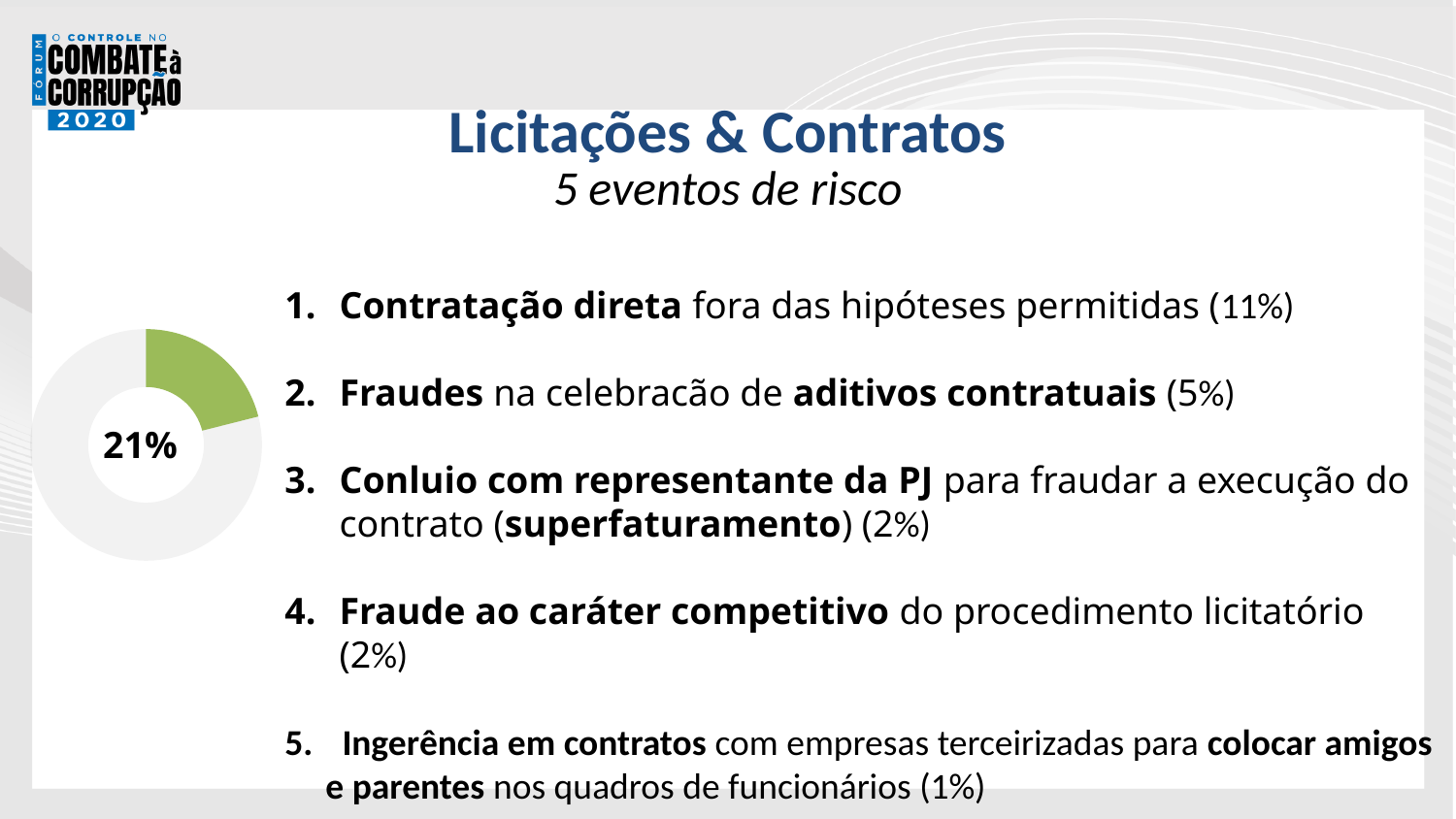
Does the donut chart include a legend? No What share of the donut chart does the green slice represent? 21% What kind of chart is shown on the left of the slide? Pie chart (donut) What colour is the highlighted slice of the donut chart? Green Is the green slice of the donut chart larger or smaller than the grey remainder? smaller What percentage is printed in the centre of the donut chart? 21% Is the value shown for the highlighted slice of the donut chart greater or less than 50%? less How many slices does the donut chart have? 2